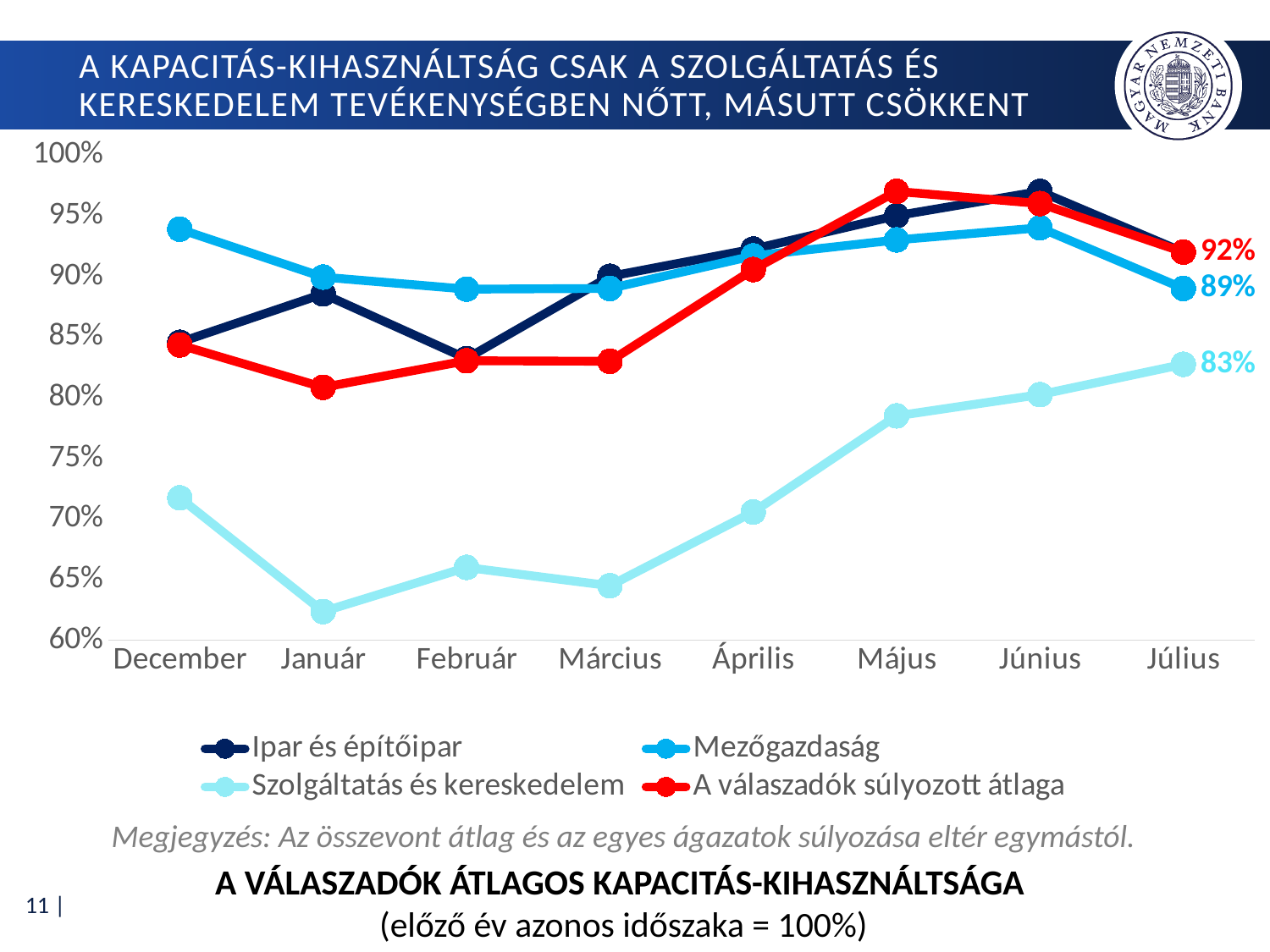
Does the Szolgáltatás és kereskedelem line rise or fall from Március to Július? rise What is the value for Szolgáltatás és kereskedelem in Július? 83% In Július, what is the difference between A válaszadók súlyozott átlaga and Szolgáltatás és kereskedelem? 9 percentage points In Május, which is higher: A válaszadók súlyozott átlaga or Szolgáltatás és kereskedelem? A válaszadók súlyozott átlaga How many series does the legend list? 4 How many months are shown on the x axis? 8 What is the value for A válaszadók súlyozott átlaga in Július? 92% Is the value for Mezőgazdaság in December greater or less than 90%? greater What is the value for Mezőgazdaság in Július? 89% Is the value for Szolgáltatás és kereskedelem in Január greater or less than 65%? less Which series has the lowest value in December? Szolgáltatás és kereskedelem What kind of chart is shown on the slide? line chart